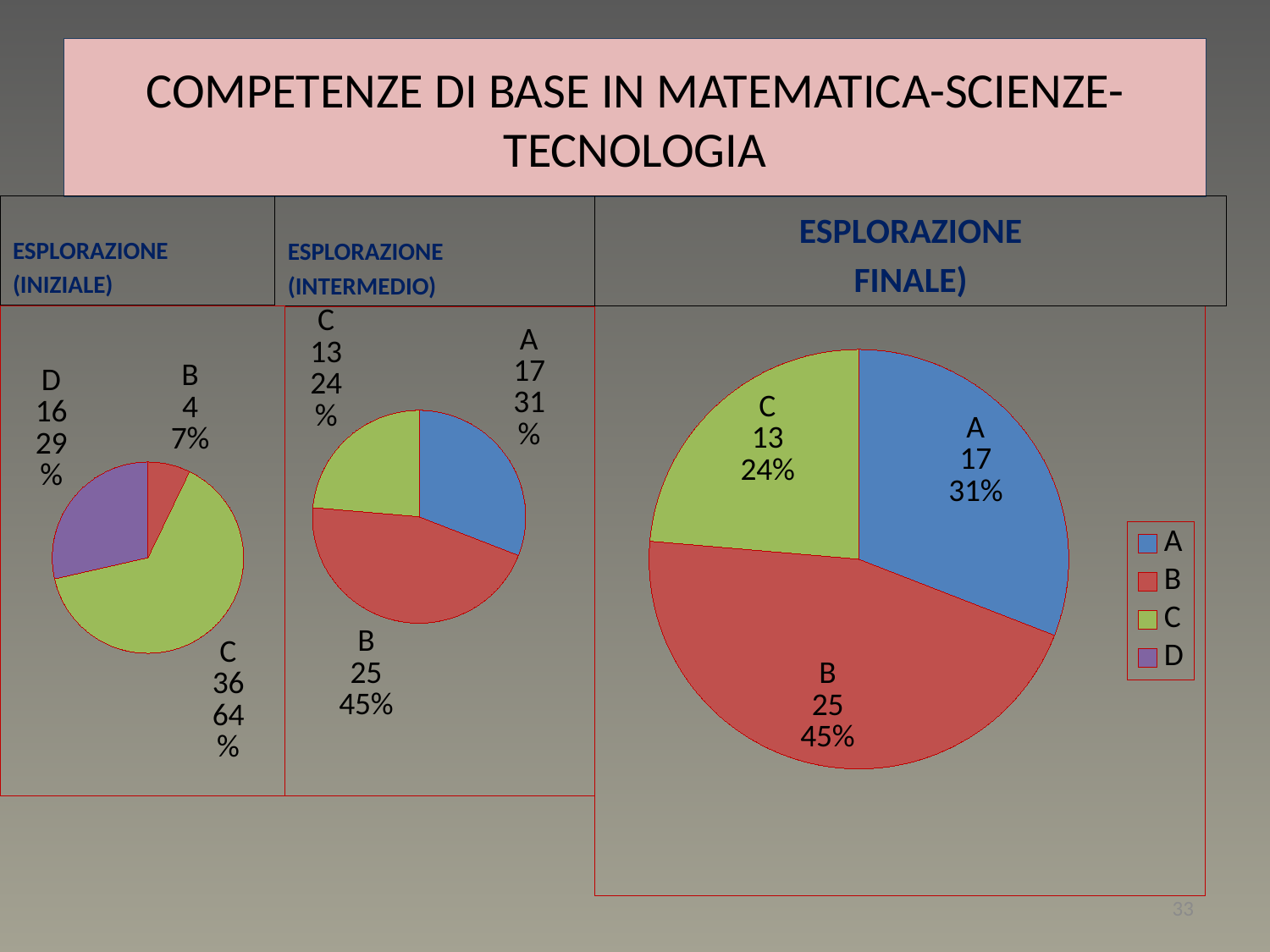
How many entries does the legend of the ESPLORAZIONE FINALE) chart list? 4 In the ESPLORAZIONE FINALE) chart, which is larger, the value for A or the value for C? A In the ESPLORAZIONE (INIZIALE) chart, which category has the smallest slice? B In the ESPLORAZIONE FINALE) chart, what is the value for C? 13 In the ESPLORAZIONE (INTERMEDIO) chart, what is the value for A? 17 In the ESPLORAZIONE (INIZIALE) chart, how many slices does the pie have? 3 In the ESPLORAZIONE (INTERMEDIO) chart, what is the difference between the values for B and C? 12 What type of chart is the ESPLORAZIONE FINALE) chart? Pie chart In the ESPLORAZIONE (INIZIALE) chart, what is the value for D? 16 In the ESPLORAZIONE (INTERMEDIO) chart, which category has the largest slice? B In the ESPLORAZIONE FINALE) chart, what percentage does slice B represent? 45% In the ESPLORAZIONE (INIZIALE) chart, what percentage does slice C represent? 64%